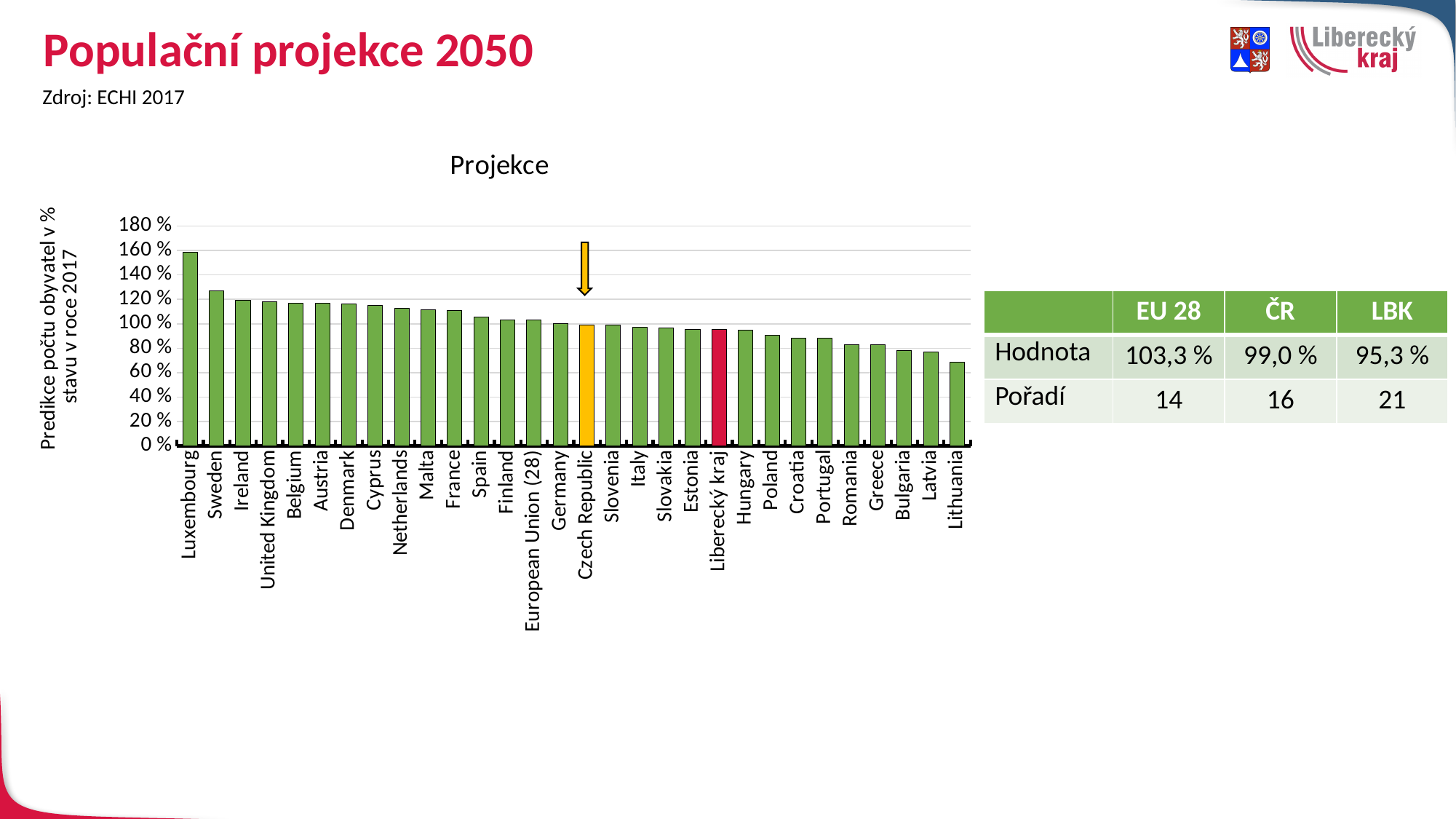
Which category has the lowest value in the chart? Lithuania According to the table, what is the value for Liberecký kraj (LBK)? 95,3 % Is the value for Hungary greater or less than 100 %? less Do the values rise or fall from left to right along the x axis? fall What is the title of the chart? Projekce Which category has the highest value in the chart? Luxembourg Is the value for Lithuania greater or less than 80 %? less According to the table, what is the difference between the EU 28 value and the ČR value? 4,3 % Which has the larger value, Sweden or Germany? Sweden Is the value for Luxembourg greater or less than 140 %? greater How many countries/regions are plotted in the chart? 30 What kind of chart is shown on the slide? bar chart